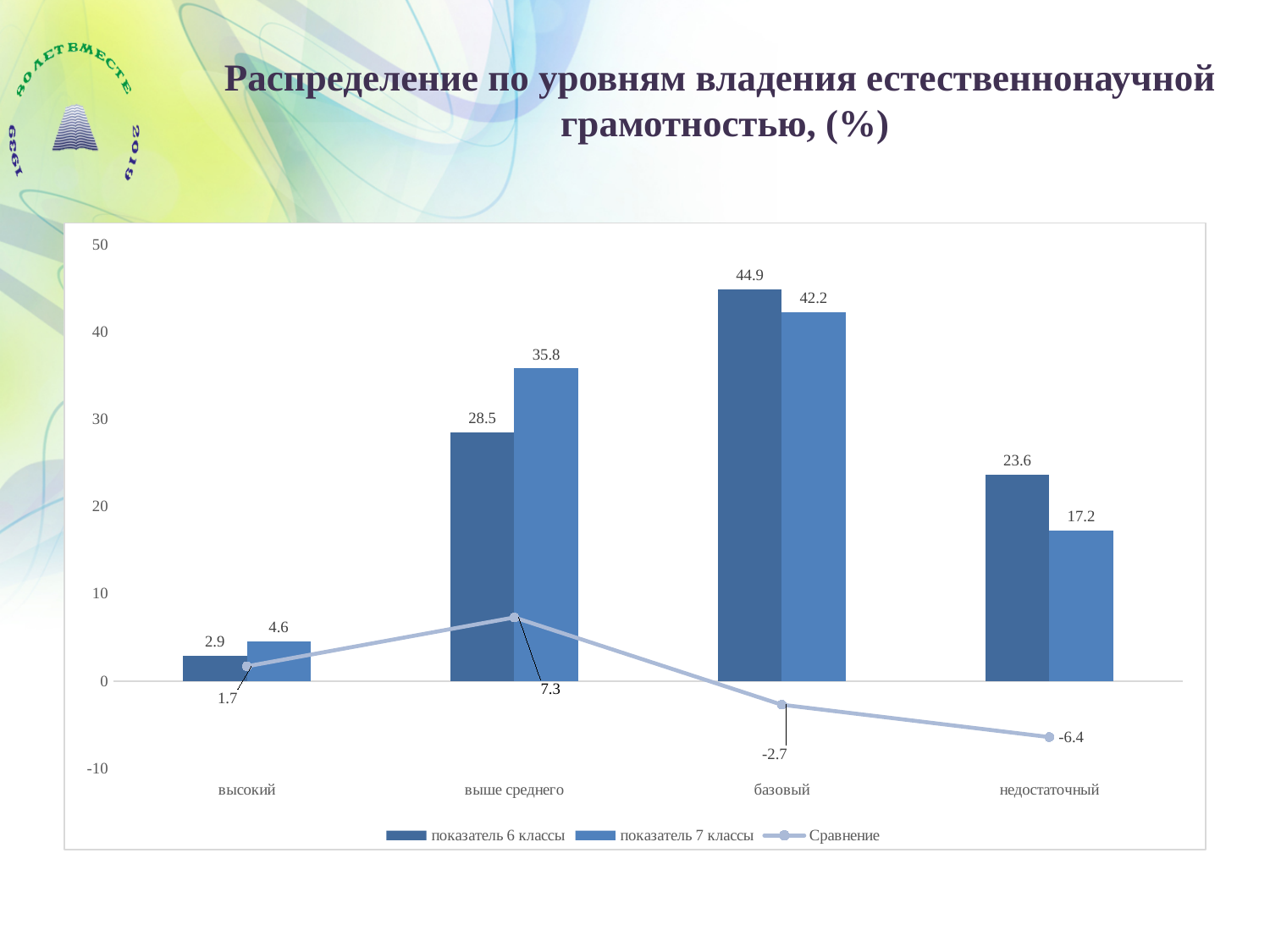
Which category has the highest value on the Сравнение line? выше среднего For the category высокий, which is larger: показатель 6 классы or показатель 7 классы? показатель 7 классы How many categories are shown on the x axis? 4 What is the value of показатель 7 классы for the category выше среднего? 35.8 How many series does the legend list? 3 What is the value of показатель 6 классы for the category базовый? 44.9 Is the value of показатель 6 классы for выше среднего greater or less than 30? less Which category has the highest value for показатель 7 классы? базовый What kind of chart is shown on the slide? Combined bar and line chart Which category has the lowest value for показатель 6 классы? высокий What is the difference between показатель 6 классы and показатель 7 классы for the category недостаточный? 6.4 What is the value of the Сравнение line for the category недостаточный? -6.4